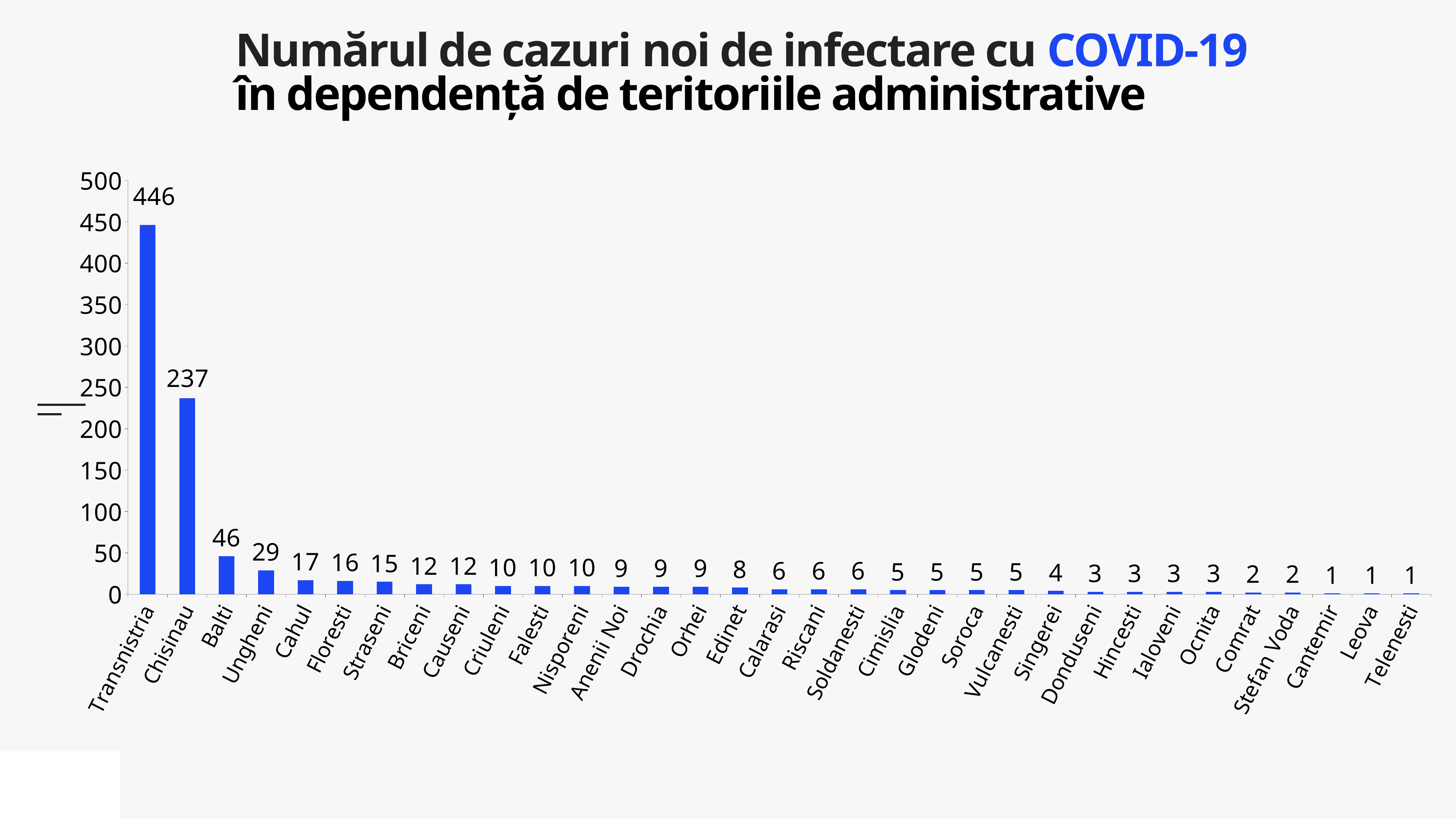
What is the value for Chisinau? 237 What is the value for Ungheni? 29 Is the value for Chisinau greater or less than 200? greater What is the value for Edinet? 8 Which category has the highest value? Transnistria How many categories are shown on the x axis? 33 What is the difference between the values for Transnistria and Chisinau? 209 What is the value for Balti? 46 What kind of chart is shown on the slide? bar chart What is the difference between the values for Balti and Ungheni? 17 Do the values rise or fall from left to right along the x axis? fall Which is larger, the value for Cahul or the value for Straseni? Cahul